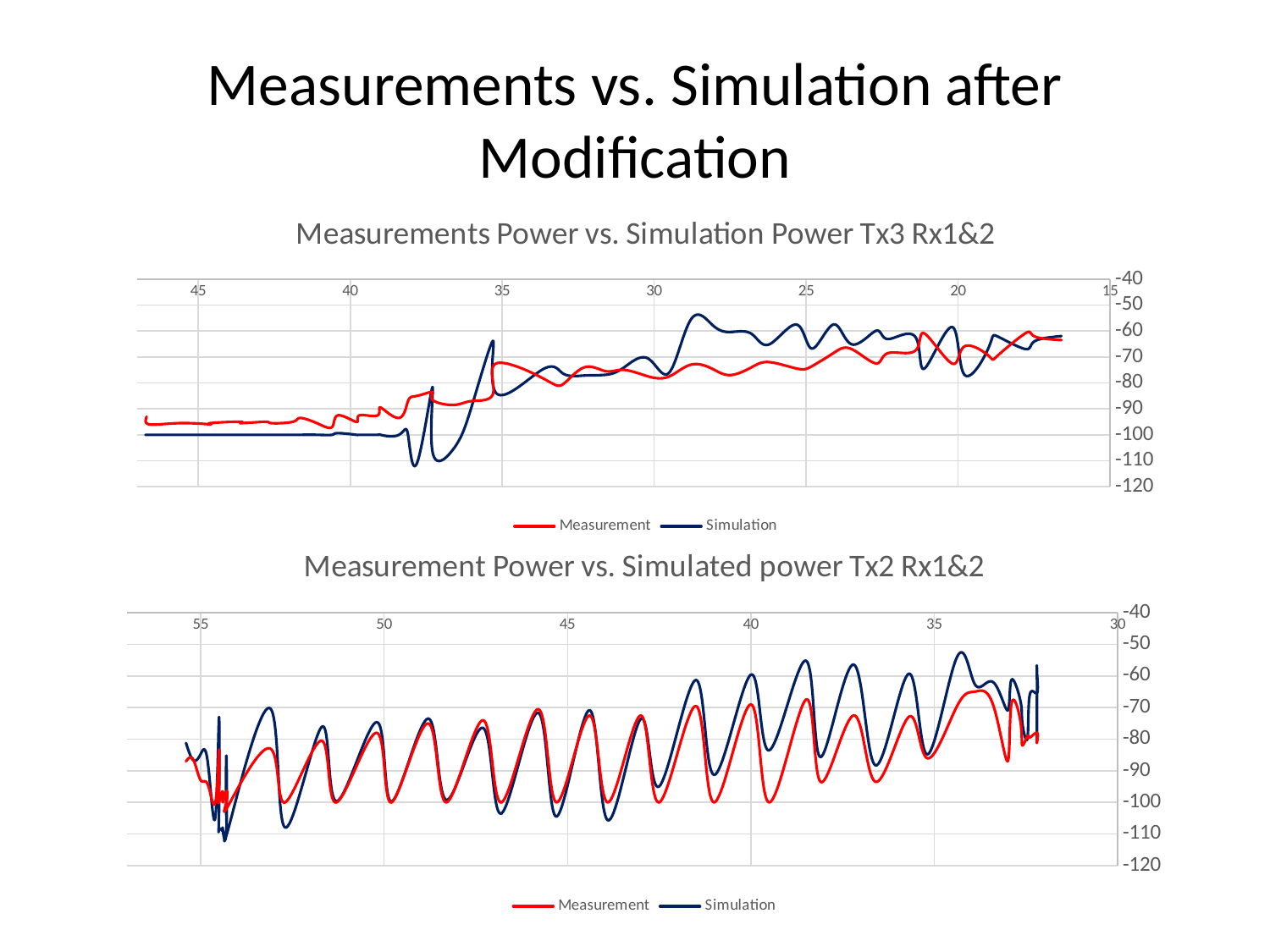
What kind of chart is the top chart, 'Measurements Power vs. Simulation Power Tx3 Rx1&2'? line chart In the top chart, is the Simulation value at x = 45 greater or less than -90? less In the top chart, do the Measurement values generally rise or fall moving from left to right along the x axis? rise In the bottom chart, which colour is used for the Simulation series? dark blue How many series does the legend of the bottom chart list? 2 In the bottom chart, is the highest peak of the Simulation series greater or less than -60? greater In the top chart, what are the two series named in the legend? Measurement and Simulation In the bottom chart, do the peaks of the Measurement series generally rise or fall moving from left to right along the x axis? rise What kind of chart is the bottom chart, 'Measurement Power vs. Simulated power Tx2 Rx1&2'? line chart In the top chart, is the Measurement value at x = 45 greater or less than -80? less How many series does the legend of the top chart list? 2 In the top chart, at x = 45, which series has the larger value, Measurement or Simulation? Measurement